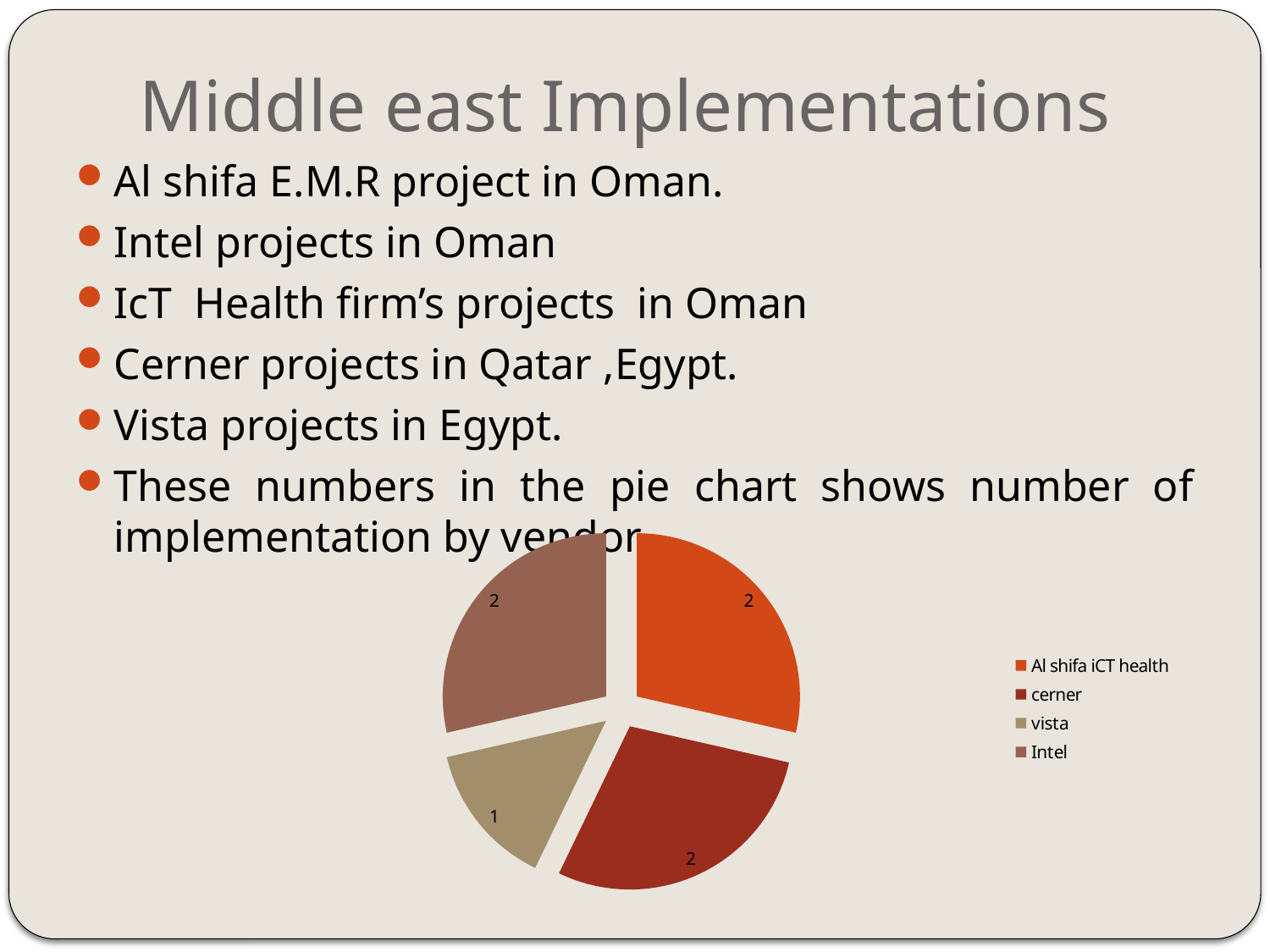
What is the value shown for the Intel slice in the pie chart? 2 What kind of chart is shown on the slide? pie chart What is the value shown for the Al shifa iCT health slice in the pie chart? 2 What is the value shown for the vista slice in the pie chart? 1 What is the value shown for the cerner slice in the pie chart? 2 Which legend entry in the pie chart is shown in orange? Al shifa iCT health How many entries does the legend of the pie chart list? 4 What is the total of all the values shown in the pie chart? 7 Which is larger in the pie chart, the value for cerner or the value for vista? cerner Which vendor has the smallest slice in the pie chart? vista What is the difference between the Intel value and the vista value in the pie chart? 1 How many slices does the pie chart have? 4